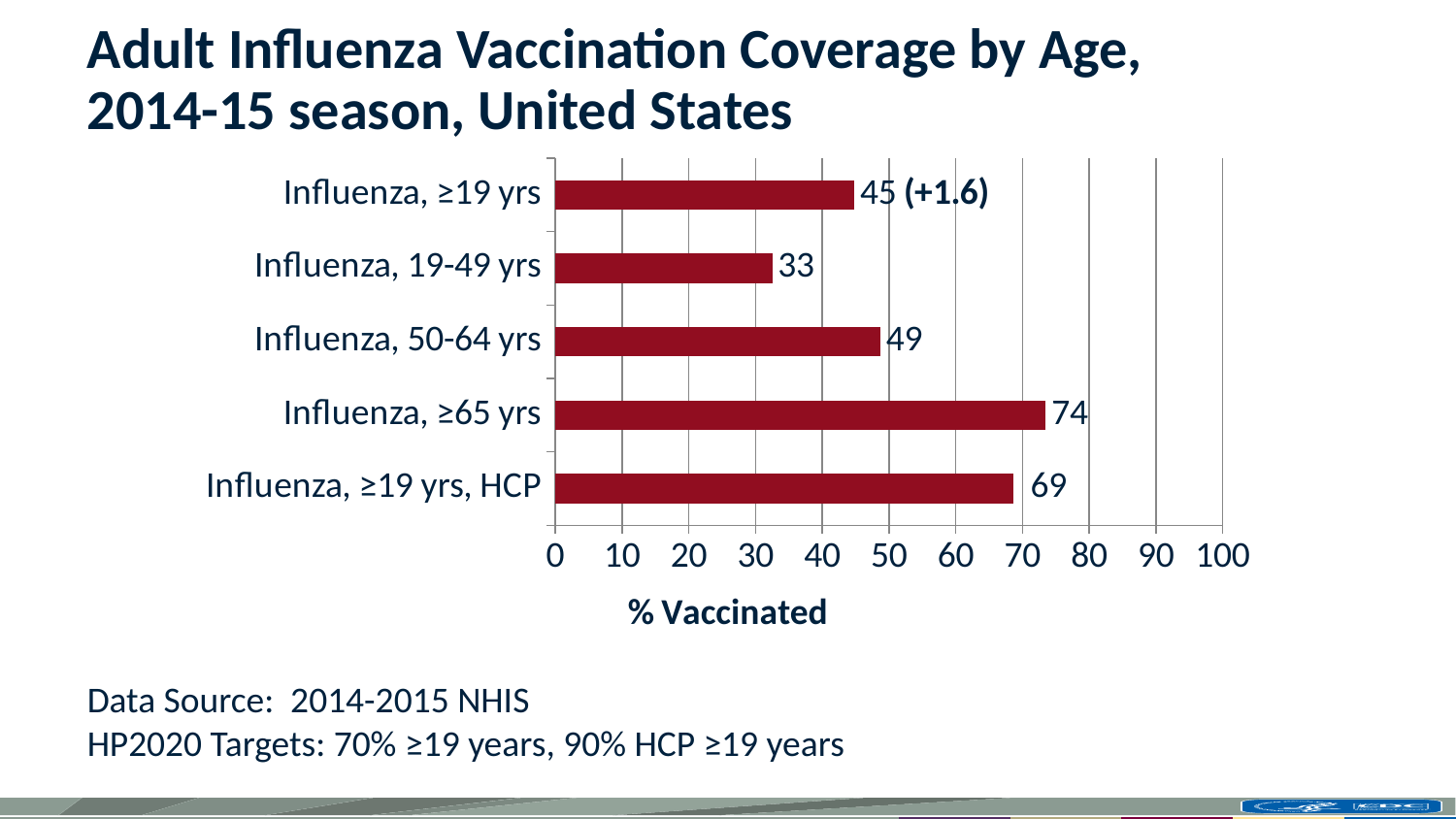
What is the % vaccinated for Influenza, 50-64 yrs? 49 Is the value for Influenza, ≥19 yrs greater or less than 50? less What is the difference in % vaccinated between Influenza, ≥65 yrs and Influenza, 19-49 yrs? 41 Which has a higher % vaccinated: Influenza, 50-64 yrs or Influenza, ≥19 yrs, HCP? Influenza, ≥19 yrs, HCP What is the % vaccinated for Influenza, ≥19 yrs, HCP? 69 Which category has the highest % vaccinated? Influenza, ≥65 yrs Which category has the lowest % vaccinated? Influenza, 19-49 yrs How many categories are shown in the chart? 5 What is the % vaccinated for Influenza, 19-49 yrs? 33 What kind of chart is shown on the slide? bar chart What is the label of the horizontal axis? % Vaccinated What is the % vaccinated for Influenza, ≥65 yrs? 74